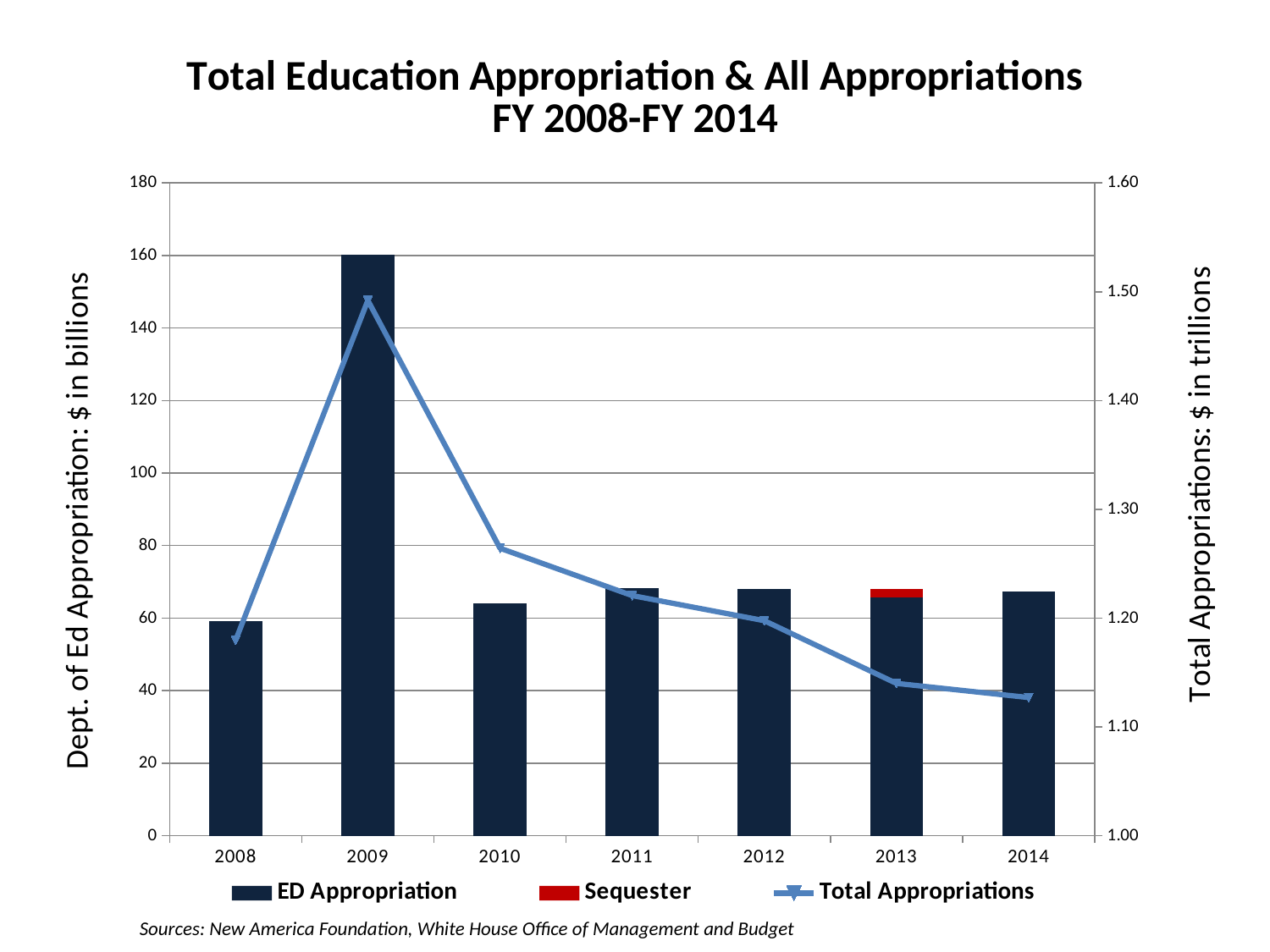
Is the Total Appropriations value for 2014 greater or less than 1.20? less Which year has the lowest ED Appropriation bar? 2008 Is the ED Appropriation value for 2009 greater or less than 140? greater Which year has the highest ED Appropriation bar? 2009 Is the Total Appropriations value for 2009 greater or less than 1.40? greater How many fiscal years are shown on the x axis? 7 Which is larger, the ED Appropriation for 2009 or for 2010? 2009 How many series does the legend list? 3 In which year does the Total Appropriations line reach its highest point? 2009 Does the Total Appropriations line rise or fall from 2009 to 2014? fall